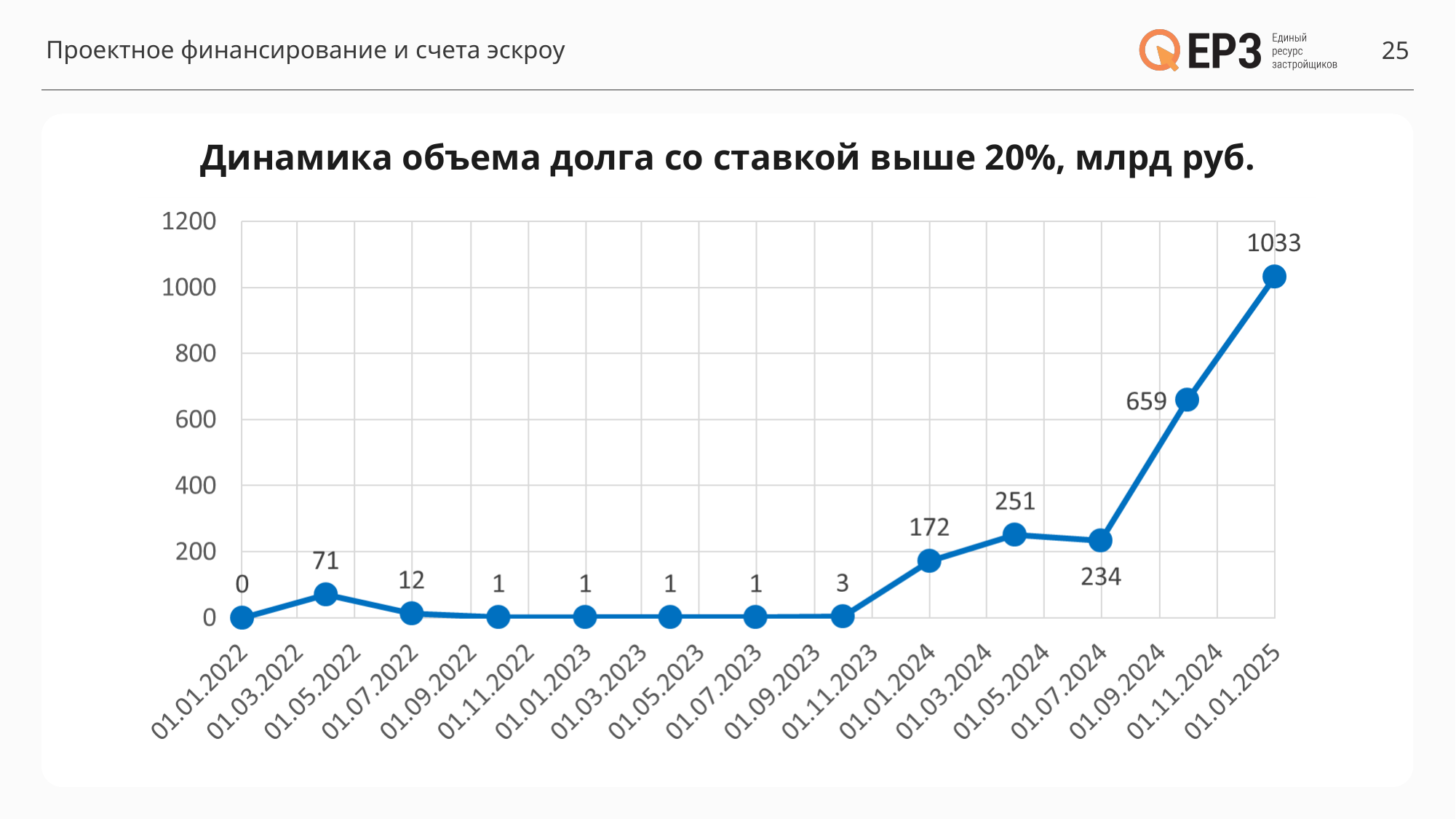
Is the value for 01.01.2025 greater or less than 1000? greater What is the value for 01.07.2024? 234 What is the difference between the values for 01.07.2024 and 01.01.2024? 62 What is the difference between the last data point (1033) and the one before it (659)? 374 What is the value for 01.01.2025? 1033 How many data points are plotted on the line? 13 What is the value for 01.07.2022? 12 What is the value for 01.01.2024? 172 Which is larger, the value for 01.01.2024 or the value for 01.07.2024? 01.07.2024 What is the highest value plotted on the chart? 1033 What kind of chart is shown on the slide? line chart Do the values rise or fall from 01.01.2024 to 01.01.2025? rise